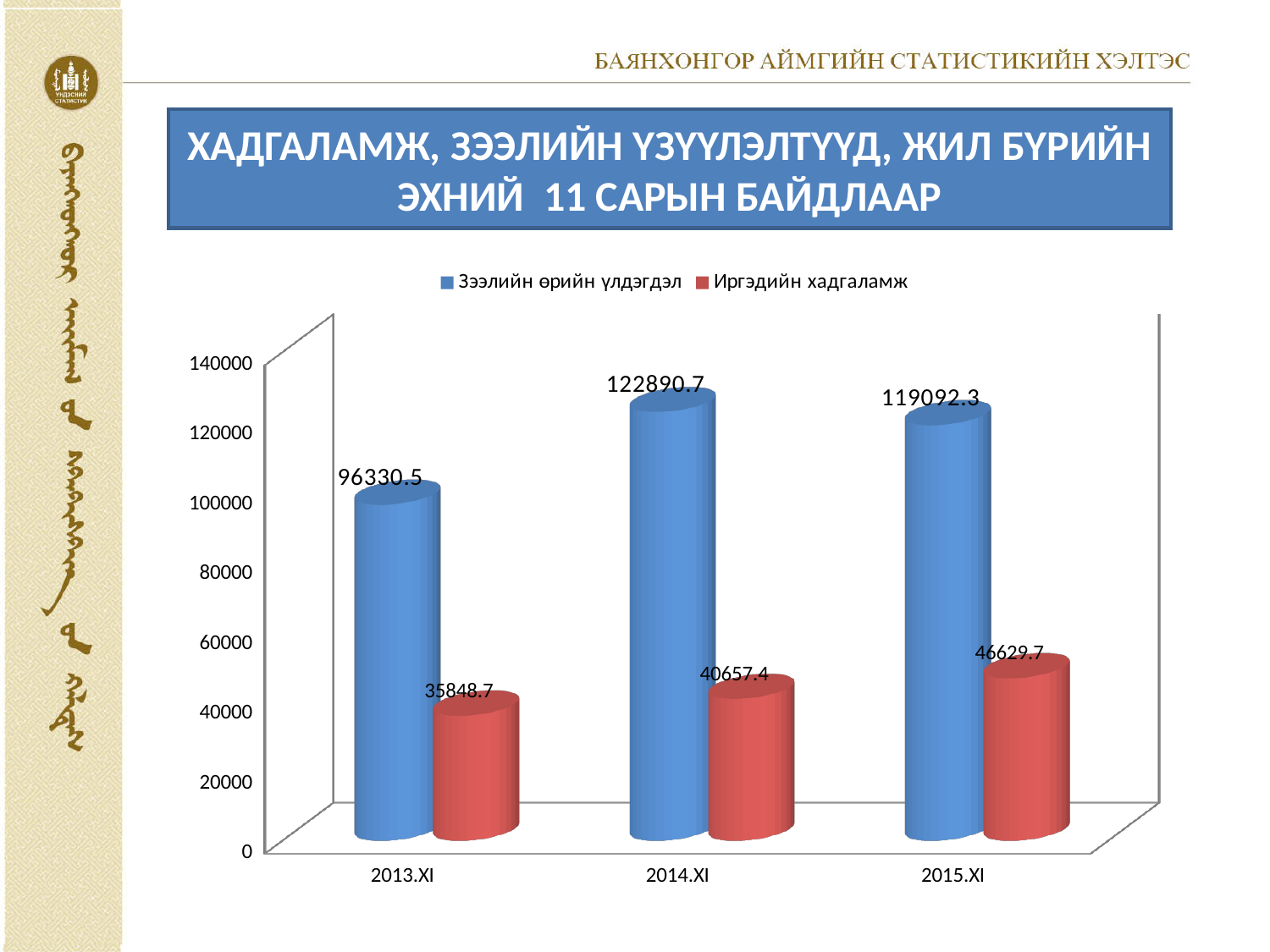
What is the value of Зээлийн өрийн үлдэгдэл for 2014.XI? 122890.7 What is the value of Иргэдийн хадгаламж for 2015.XI? 46629.7 In which period is Иргэдийн хадгаламж lowest? 2013.XI Which is larger: Зээлийн өрийн үлдэгдэл in 2014.XI or in 2015.XI? 2014.XI What is the difference between Зээлийн өрийн үлдэгдэл and Иргэдийн хадгаламж in 2014.XI? 82233.3 How many series does the legend list? 2 What is the value of Иргэдийн хадгаламж for 2013.XI? 35848.7 How many periods are shown on the x axis? 3 What is the value of Зээлийн өрийн үлдэгдэл for 2013.XI? 96330.5 Does Иргэдийн хадгаламж rise or fall from 2013.XI to 2015.XI? rise Is the value of Иргэдийн хадгаламж for 2015.XI greater or less than 60000? less In which period is Зээлийн өрийн үлдэгдэл highest? 2014.XI